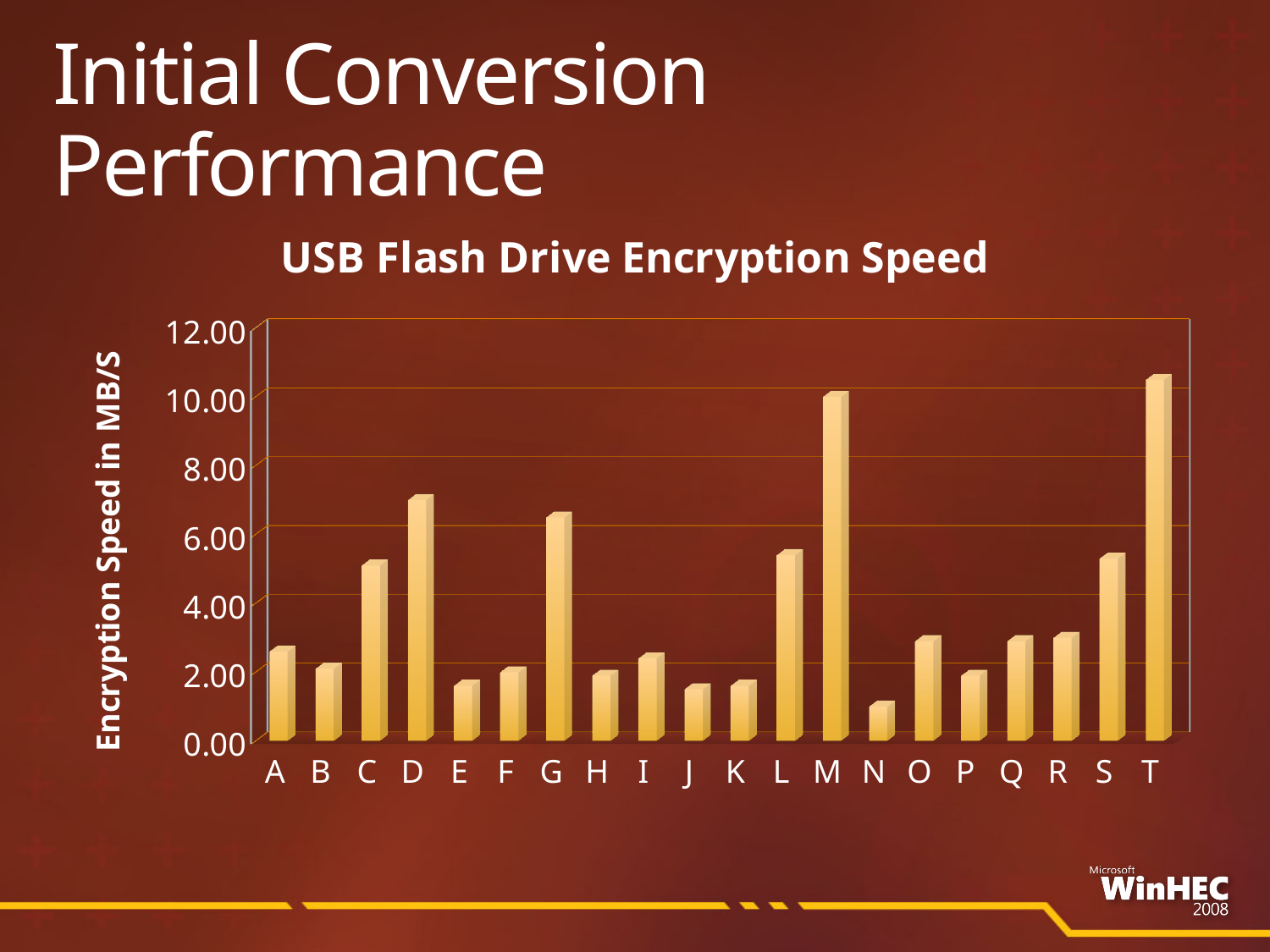
What is the label on the vertical axis of the chart? Encryption Speed in MB/S Is the value for C greater or less than 4.00? greater Is the value for M greater or less than 8.00? greater Which category has the lowest encryption speed? N Which has the larger encryption speed, G or L? G Is the value for N greater or less than 2.00? less Which has the larger encryption speed, C or D? D Which category has the highest encryption speed? T What is the title of the chart? USB Flash Drive Encryption Speed What kind of chart is shown on the slide? bar chart How many categories (drives) are plotted on the x axis? 20